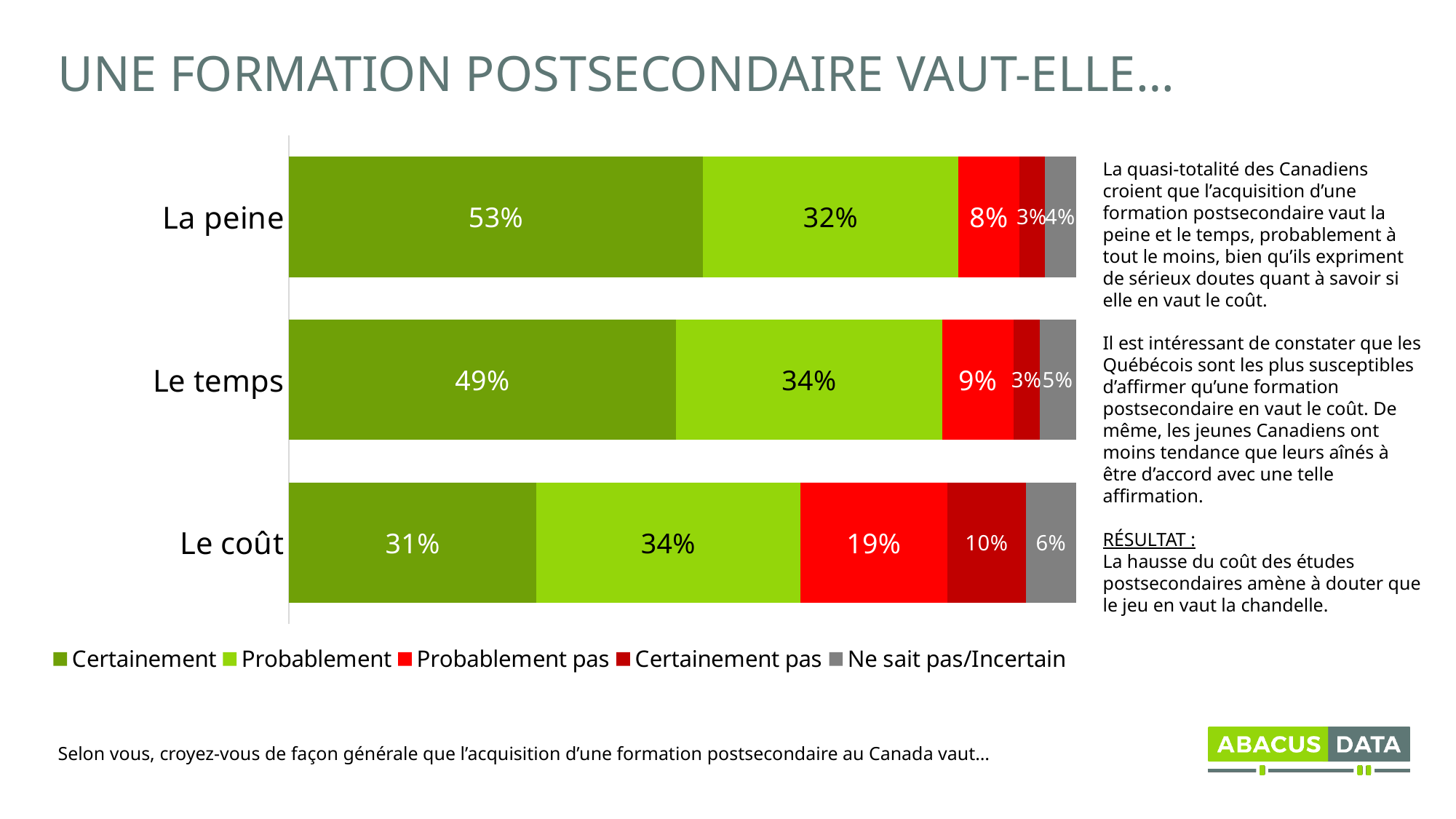
Which category has the lowest "Certainement" share? Le coût How many series does the legend list? 5 Which is larger: the "Probablement pas" share for "Le temps" or for "La peine"? Le temps What percentage of respondents answered "Probablement pas" for "Le coût"? 19% What colour represents "Ne sait pas/Incertain" in the chart? Grey What percentage of respondents answered "Certainement" for "La peine"? 53% What is the difference between the "Certainement" share for "La peine" and for "Le coût"? 22 percentage points What kind of chart is shown on the slide? Stacked bar chart How many categories are shown on the chart? 3 Which category has the highest "Certainement" share? La peine What percentage of respondents answered "Certainement pas" for "Le temps"? 3% What percentage of respondents answered "Ne sait pas/Incertain" for "Le coût"? 6%